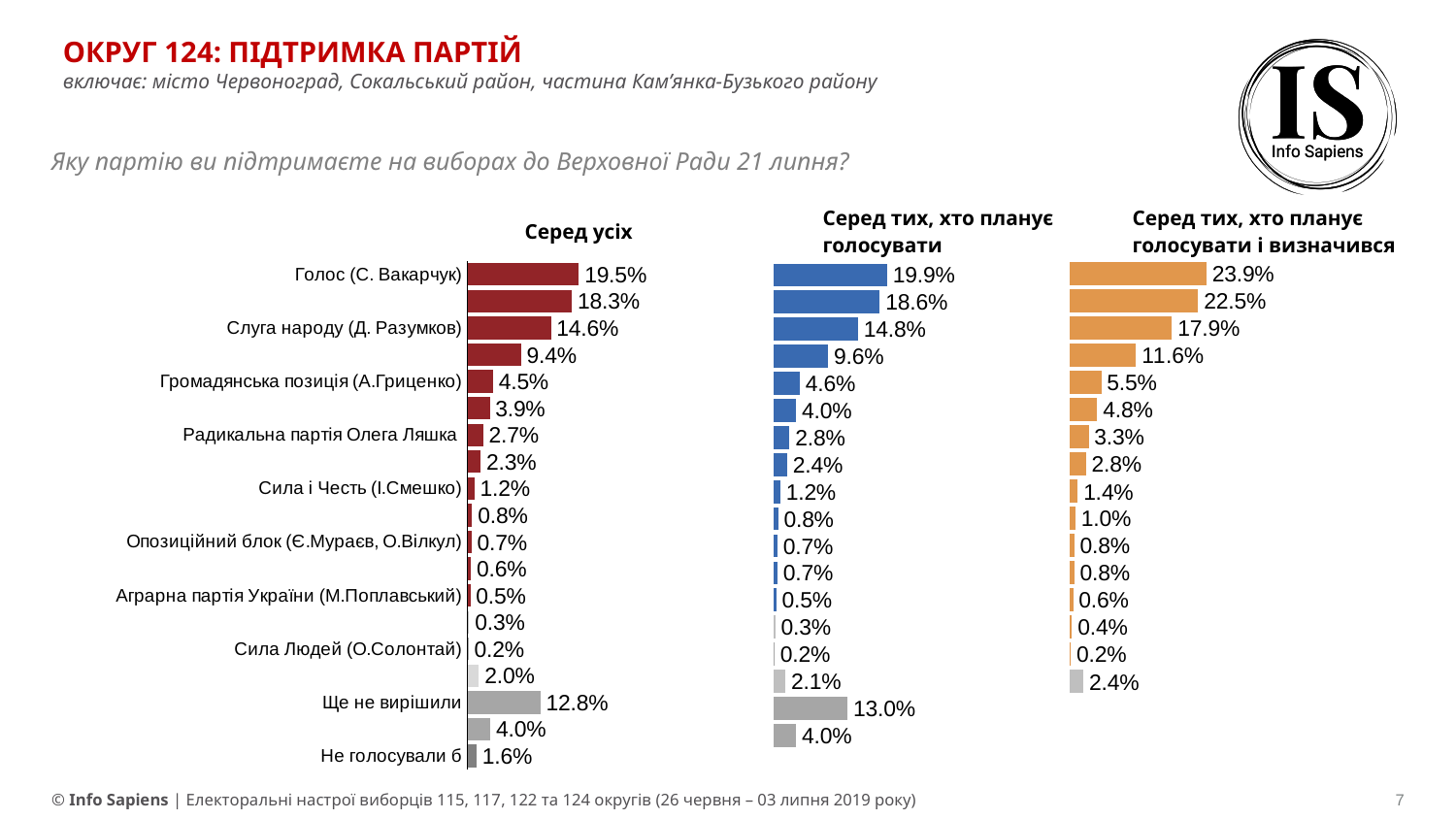
What type of chart is used on this slide? Bar chart How many charts are shown on the slide? 3 In the 'Серед усіх' chart, what is the value for Голос (С. Вакарчук)? 19.5% In the 'Серед усіх' chart, which is larger: Громадянська позиція (А.Гриценко) or Радикальна партія Олега Ляшка? Громадянська позиція (А.Гриценко) In the 'Серед усіх' chart, what is the value for Слуга народу (Д. Разумков)? 14.6% In the 'Серед тих, хто планує голосувати' chart, what is the value for Голос (С. Вакарчук)? 19.9% In the 'Серед усіх' chart, which party has the highest value? Голос (С. Вакарчук) In the 'Серед усіх' chart, what is the value for Ще не вирішили? 12.8% In the 'Серед тих, хто планує голосувати і визначився' chart, what is the value for Слуга народу (Д. Разумков)? 17.9% In the 'Серед тих, хто планує голосувати і визначився' chart, what is the value for Голос (С. Вакарчук)? 23.9% In the 'Серед усіх' chart, what is the value for Не голосували б? 1.6% In the 'Серед усіх' chart, what is the difference between Голос (С. Вакарчук) and Слуга народу (Д. Разумков)? 4.9%